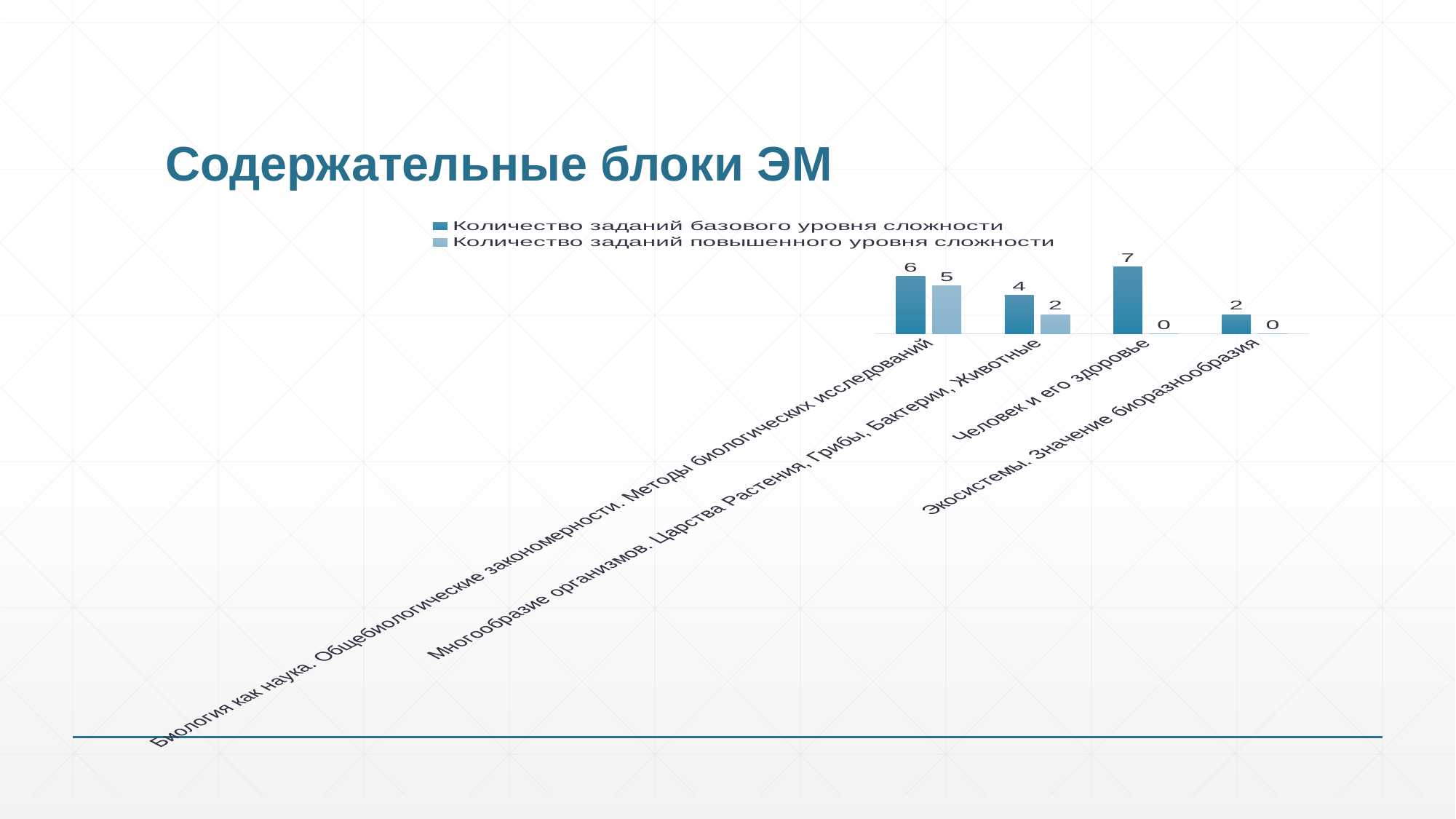
What is the value of 'Количество заданий базового уровня сложности' for 'Человек и его здоровье'? 7 Which is larger for 'Биология как наука. Общебиологические закономерности. Методы биологических исследований': the base-level value or the advanced-level value? the base-level value What is the value of 'Количество заданий базового уровня сложности' for 'Экосистемы. Значение биоразнообразия'? 2 What is the title of the slide? Содержательные блоки ЭМ What is the value of 'Количество заданий повышенного уровня сложности' for 'Многообразие организмов. Царства Растения, Грибы, Бактерии, Животные'? 2 What is the value of 'Количество заданий повышенного уровня сложности' for 'Биология как наука. Общебиологические закономерности. Методы биологических исследований'? 5 How many series does the legend list? 2 How many categories are shown on the x axis? 4 What is the difference between the base-level and advanced-level values for 'Многообразие организмов. Царства Растения, Грибы, Бактерии, Животные'? 2 Which category has the highest value for 'Количество заданий базового уровня сложности'? Человек и его здоровье Which category has the lowest value for 'Количество заданий базового уровня сложности'? Экосистемы. Значение биоразнообразия What kind of chart is shown on the slide? bar chart